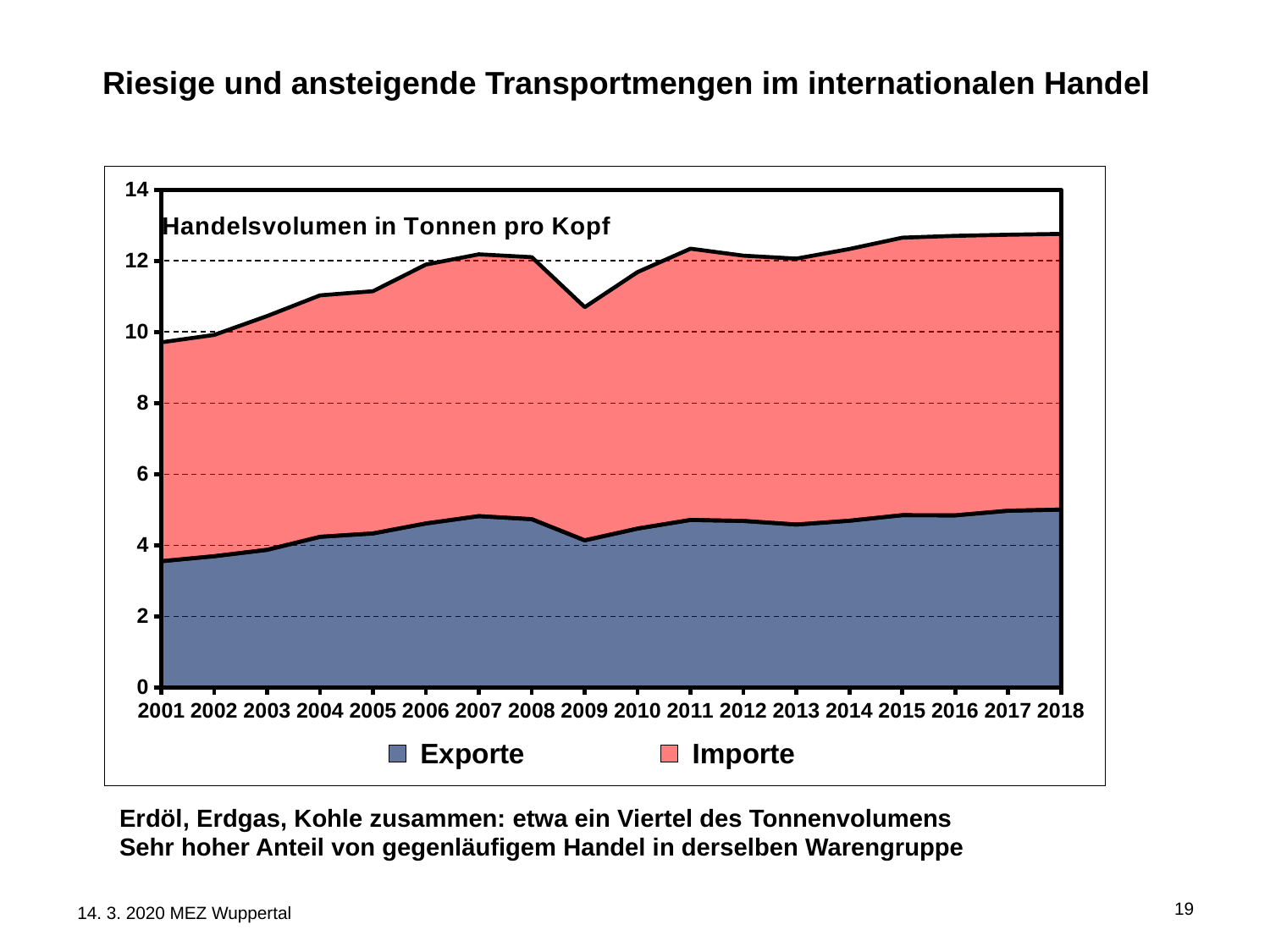
Which year has the larger Exporte value, 2007 or 2009? 2007 What kind of chart is shown on the slide? Stacked area chart Is the total stacked value (Exporte plus Importe) in 2018 greater or less than 12? greater Is the value for Exporte in 2001 greater or less than 4? less How many series does the chart legend list? 2 How many years are shown on the x axis of the chart? 18 Does the Exporte series generally rise or fall from 2001 to 2018? rise What is the title printed inside the chart area? Handelsvolumen in Tonnen pro Kopf Is the value for Exporte in 2007 greater or less than 4? greater In which year is the total stacked value (Exporte plus Importe) lowest? 2001 What are the two series named in the chart legend? Exporte and Importe